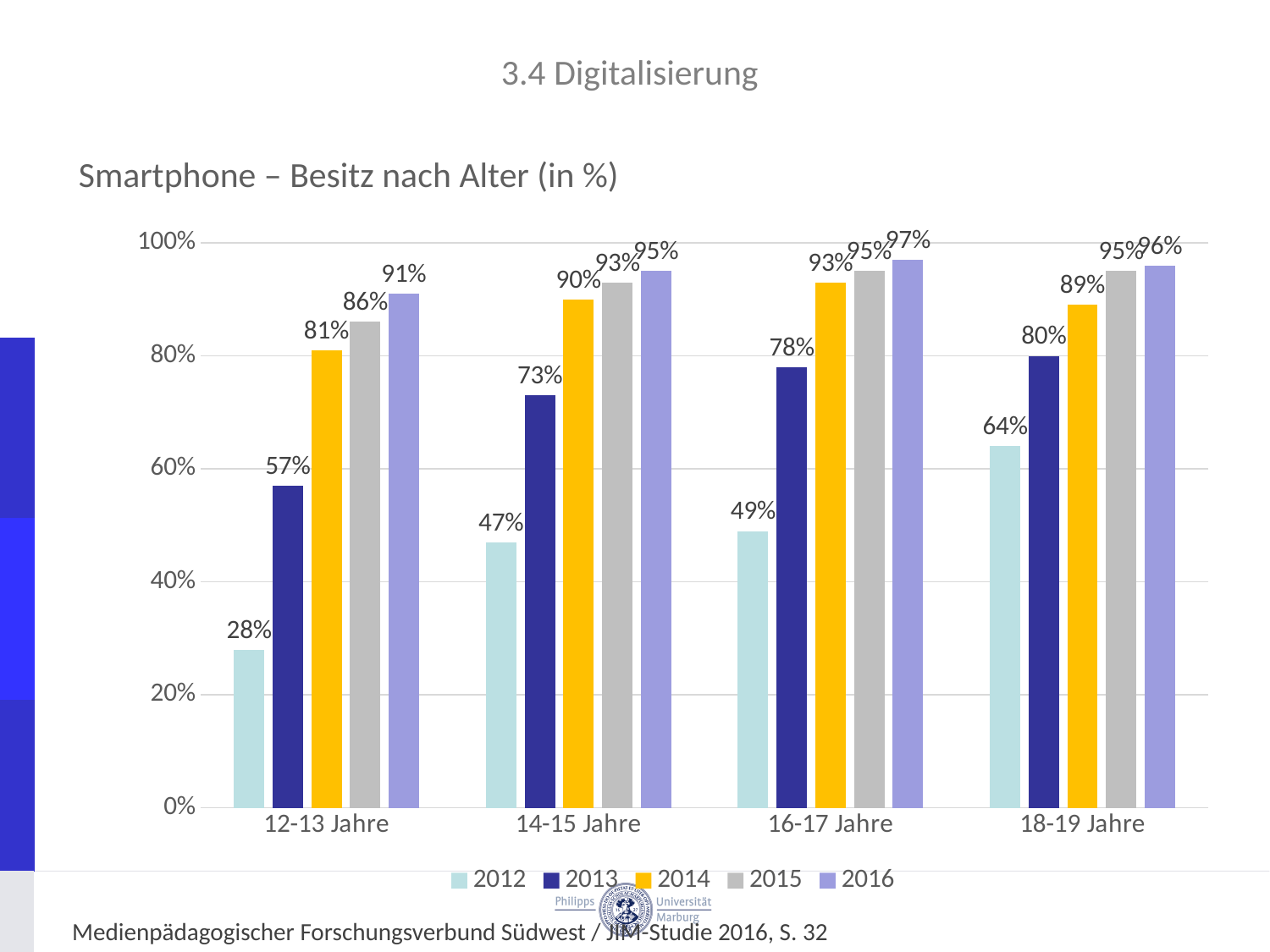
Which age group has the lowest value for 2012? 12-13 Jahre How many age groups are shown on the x axis? 4 How many series does the legend list? 5 What is the value for 2014 in the 16-17 Jahre group? 93% Which is larger: the 2013 value for 16-17 Jahre or the 2013 value for 14-15 Jahre? 16-17 Jahre What is the value for 2013 in the 18-19 Jahre group? 80% What is the value for 2012 in the 12-13 Jahre group? 28% Which age group has the highest value for 2016? 16-17 Jahre What kind of chart is shown? bar chart Within the 12-13 Jahre group, do the values rise or fall from 2012 to 2016? rise What is the title of the chart? Smartphone – Besitz nach Alter (in %) What is the difference between the 2016 and 2012 values for 14-15 Jahre? 48%